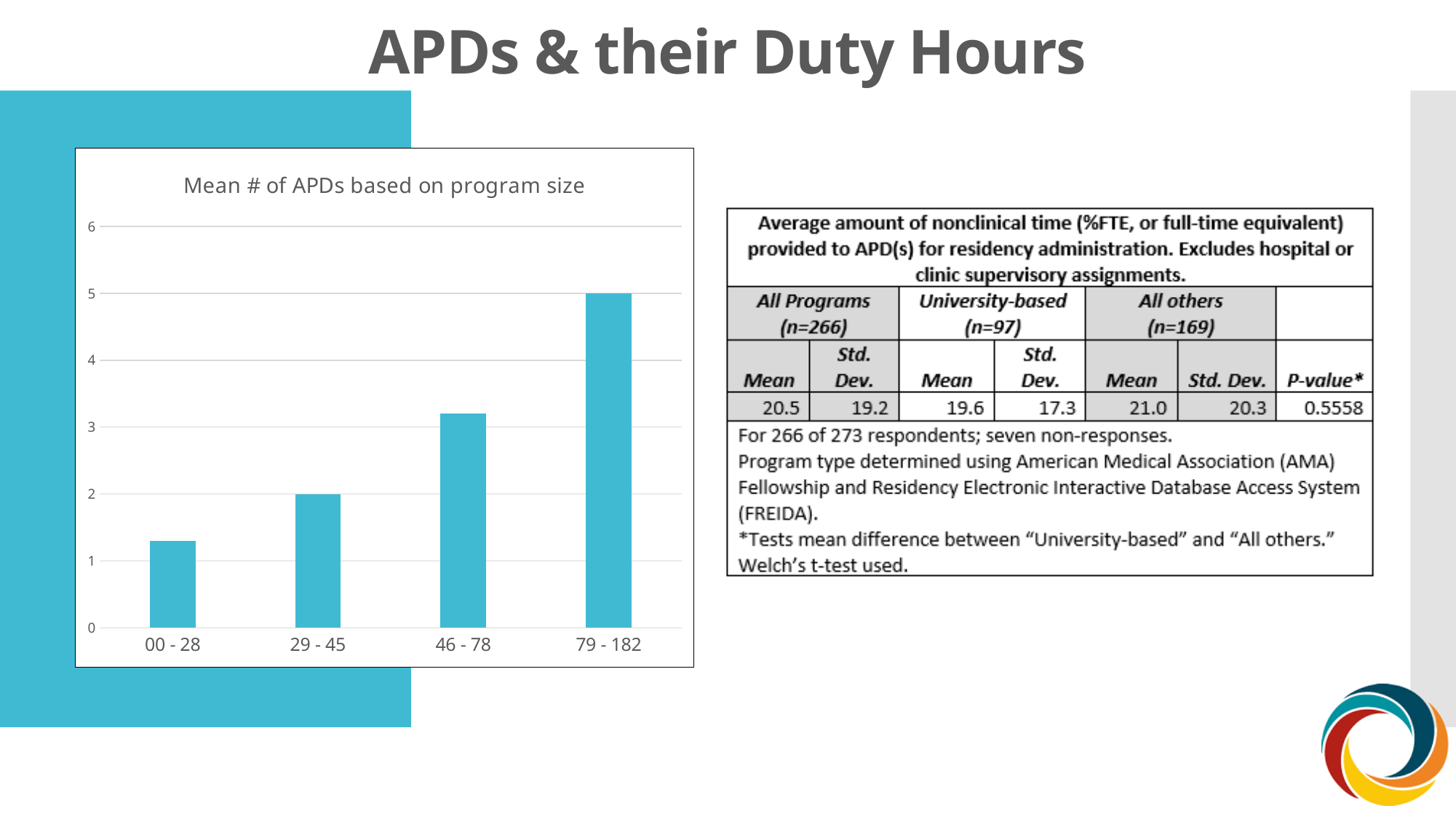
Which category has a larger mean number of APDs, 46 - 78 or 29 - 45? 46 - 78 Is the mean number of APDs for the 46 - 78 category greater or less than 3? greater What is the title of the chart on the slide? Mean # of APDs based on program size Which program size category has the highest mean number of APDs? 79 - 182 Is the mean number of APDs for the 00 - 28 category greater or less than 2? less How many program size categories are shown on the chart? 4 What is the mean number of APDs for the 79 - 182 program size category? 5 What kind of chart is shown on the slide? Bar chart What is the mean number of APDs for the 29 - 45 program size category? 2 Do the mean numbers of APDs rise or fall as program size increases along the x axis? Rise Which program size category has the lowest mean number of APDs? 00 - 28 What is the difference in mean number of APDs between the 79 - 182 and 29 - 45 categories? 3